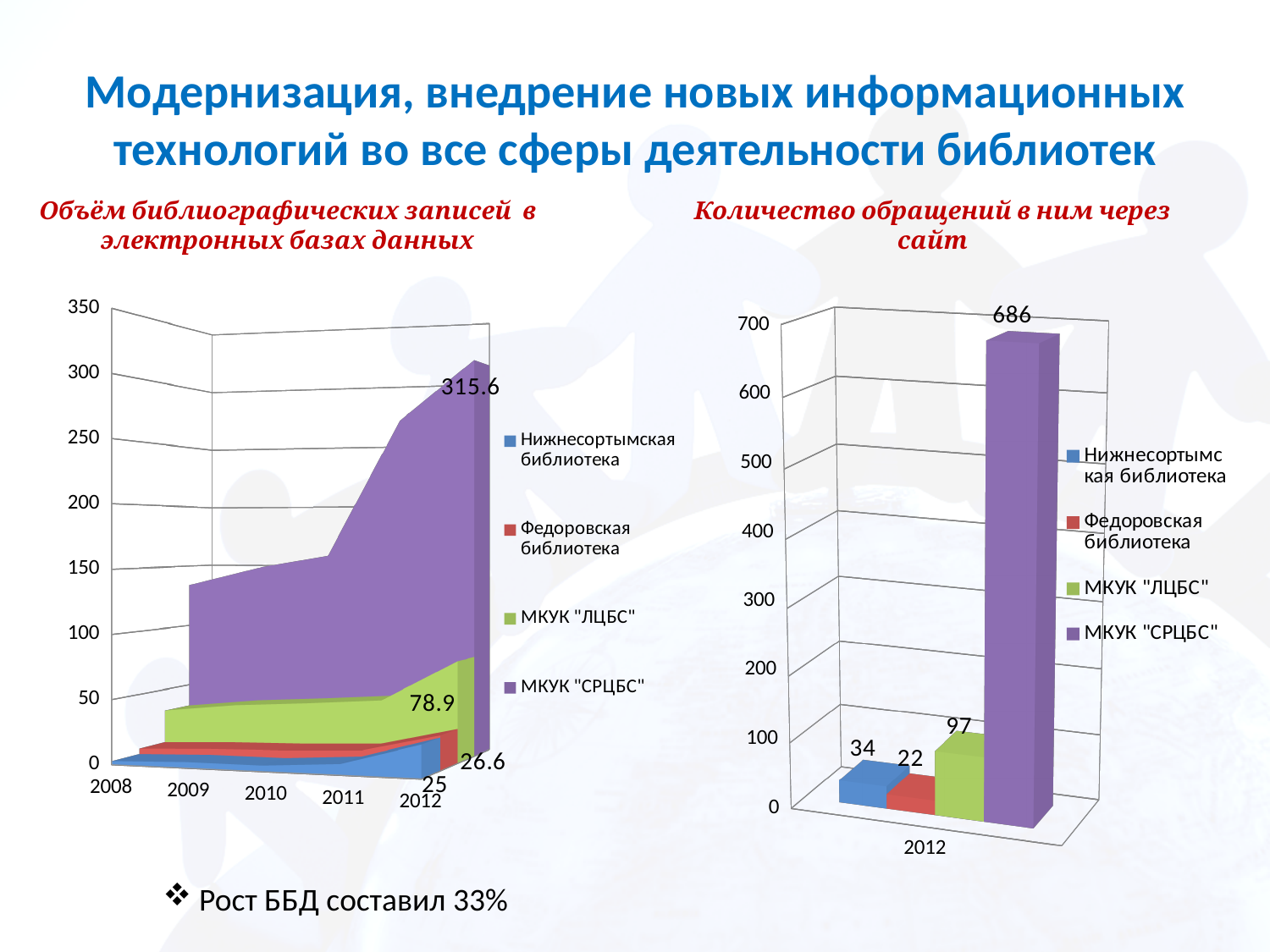
On the chart 'Объём библиографических записей в электронных базах данных', what is the value for МКУК "СРЦБС" in 2012? 315.6 On the chart 'Объём библиографических записей в электронных базах данных', does the value for МКУК "СРЦБС" rise or fall from 2008 to 2012? rise On the chart 'Количество обращений в ним через сайт', what is the difference between МКУК "ЛЦБС" and Нижнесортымская библиотека? 63 On the chart 'Объём библиографических записей в электронных базах данных', how many years are shown on the x axis? 5 On the chart 'Количество обращений в ним через сайт', how many series does the legend list? 4 On the chart 'Количество обращений в ним через сайт', which library has the highest value? МКУК "СРЦБС" On the chart 'Количество обращений в ним через сайт', what is the value for Федоровская библиотека? 22 On the chart 'Количество обращений в ним через сайт', what is the value for МКУК "СРЦБС"? 686 On the chart 'Объём библиографических записей в электронных базах данных', what is the value for МКУК "ЛЦБС" in 2012? 78.9 On the chart 'Количество обращений в ним через сайт', what is the value for МКУК "ЛЦБС"? 97 On the chart 'Количество обращений в ним через сайт', which library has the lowest value? Федоровская библиотека What kind of chart is 'Количество обращений в ним через сайт'? bar chart